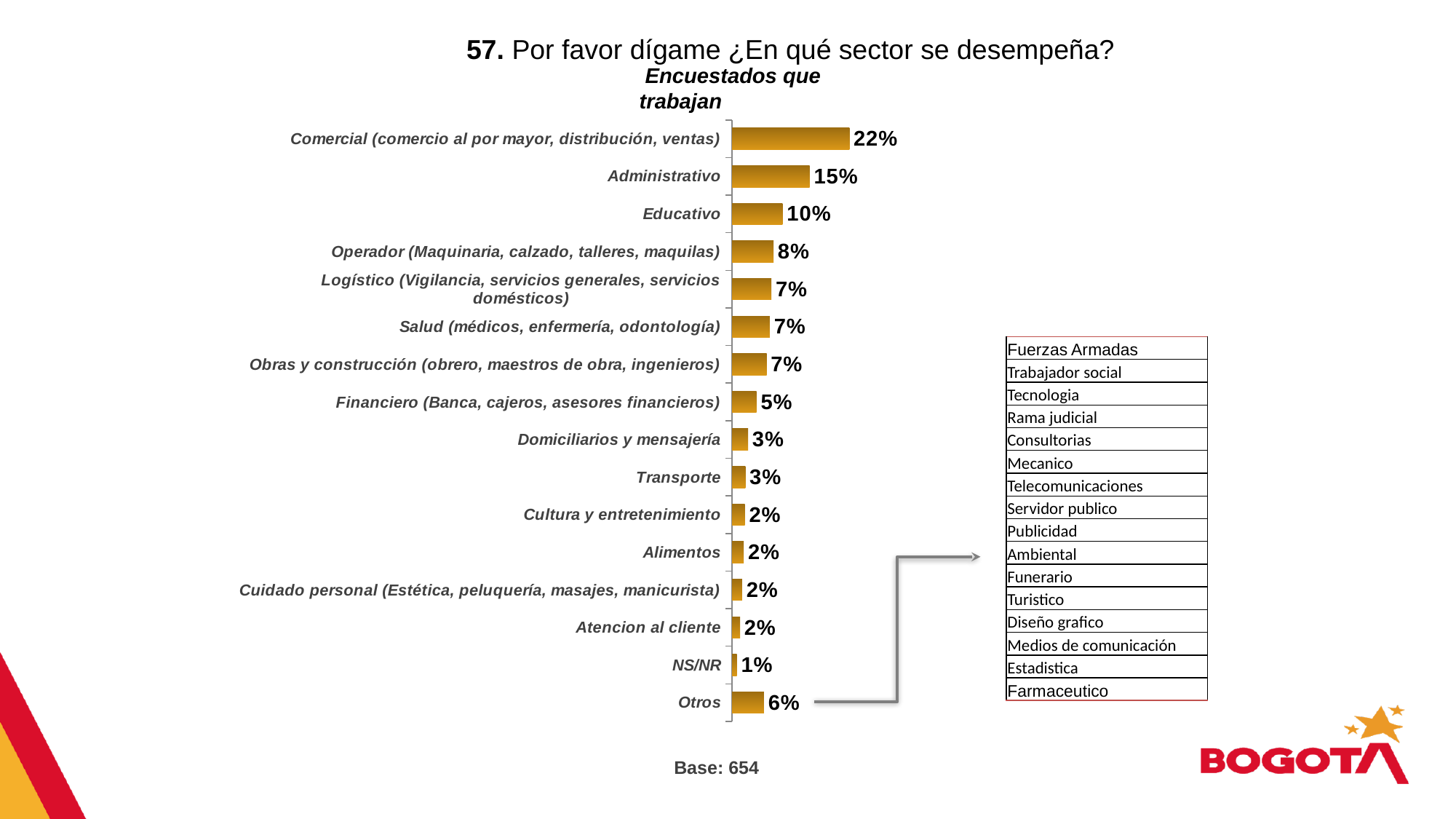
What percentage of respondents work in the Administrativo sector? 15% Which is larger, the value for Operador (Maquinaria, calzado, talleres, maquilas) or the value for Transporte? Operador (Maquinaria, calzado, talleres, maquilas) What is the difference between the Comercial and Administrativo percentages? 7% What is the title of the chart? Encuestados que trabajan What type of chart is shown on the slide? Bar chart What is the value for Financiero (Banca, cajeros, asesores financieros)? 5% Which category has the lowest percentage? NS/NR Which sector has the highest percentage? Comercial (comercio al por mayor, distribución, ventas) What is the value shown for Educativo? 10% How many categories are shown in the bar chart? 16 What is the base (number of respondents) shown below the chart? 654 What percentage is shown for Otros? 6%